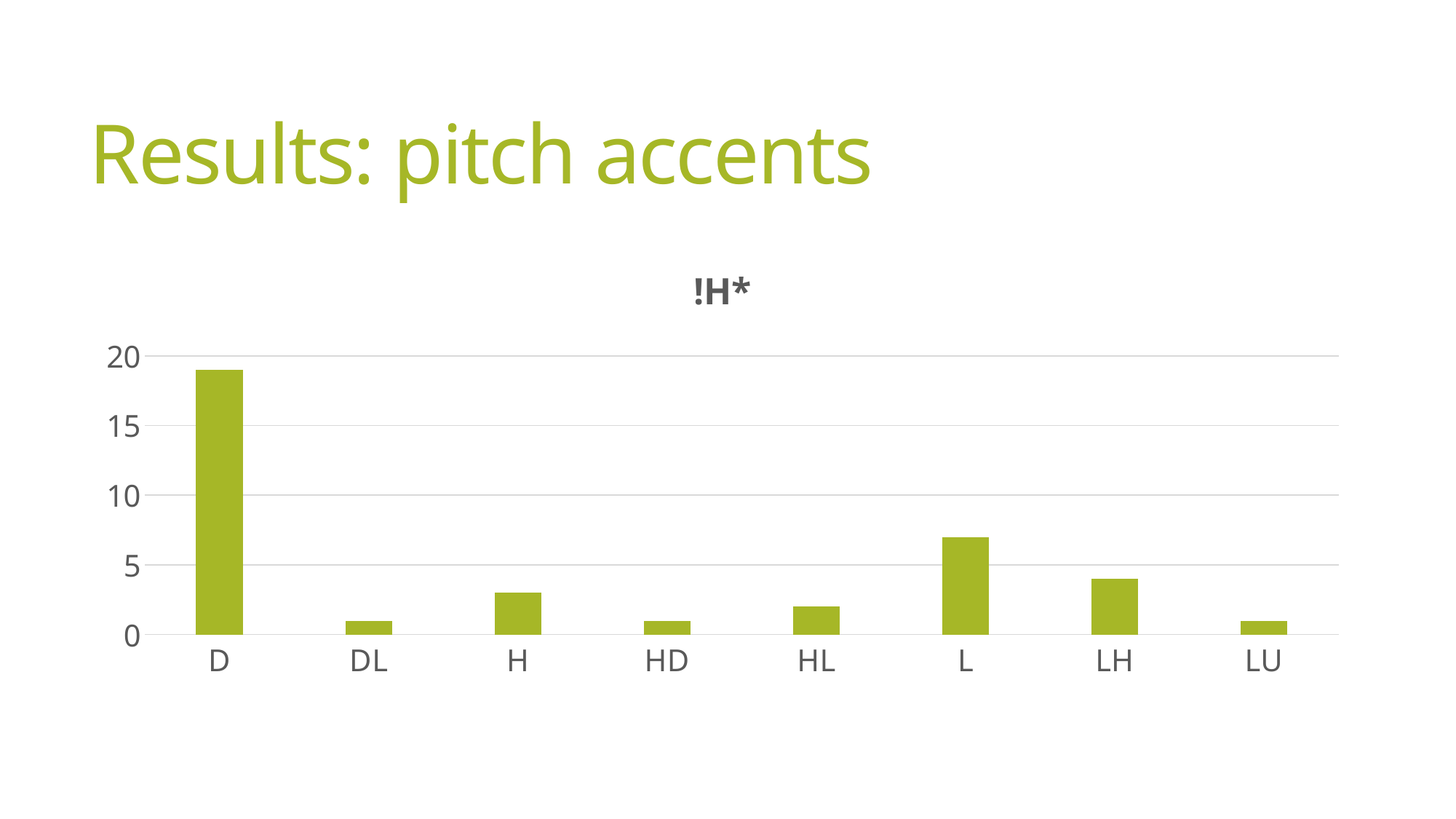
What is the title of the chart? !H* How many categories are shown on the x axis of the chart? 8 Is the value for D greater or less than 15? greater Which has a larger value, L or LH? L Is the value for H greater or less than 5? less What type of chart is shown on the slide? bar chart Is the value for L greater or less than 5? greater What colour are the bars in the chart? green Which has a larger value, D or L? D Which category has the highest value in the chart? D